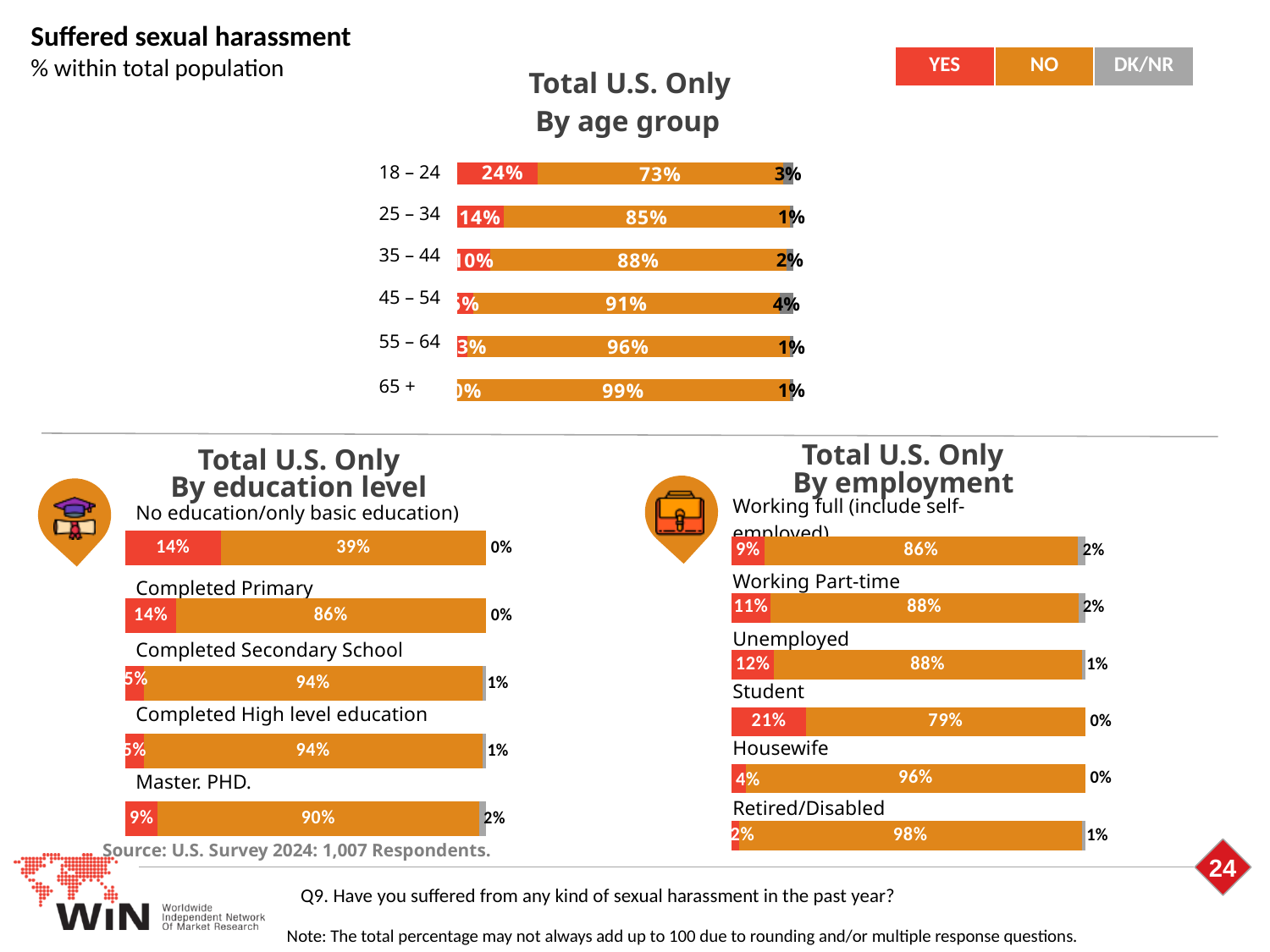
In the 'Total U.S. Only By age group' chart, what is the difference between the NO values for 55 – 64 and 18 – 24? 23 percentage points In the 'Total U.S. Only By employment' chart, which is larger, the YES value for Unemployed or the YES value for Housewife? Unemployed In the 'Total U.S. Only By age group' chart, which age group has the highest YES value? 18 – 24 In the 'Total U.S. Only By education level' chart, what is the YES value for 'Master. PHD.'? 9% In the 'Total U.S. Only By employment' chart, which employment category has the highest YES value? Student In the 'Total U.S. Only By age group' chart, how many age groups are shown? 6 How many series does the legend list? 3 In the 'Total U.S. Only By education level' chart, what is the NO value for 'No education/only basic education'? 39% In the 'Total U.S. Only By age group' chart, what is the YES value for the 18 – 24 age group? 24% In the 'Total U.S. Only By age group' chart, what is the NO value for the 65 + age group? 99% What kind of chart is the 'Total U.S. Only By employment' chart? stacked bar chart In the 'Total U.S. Only By age group' chart, do the NO values rise or fall as age increases from 18 – 24 to 65 +? rise